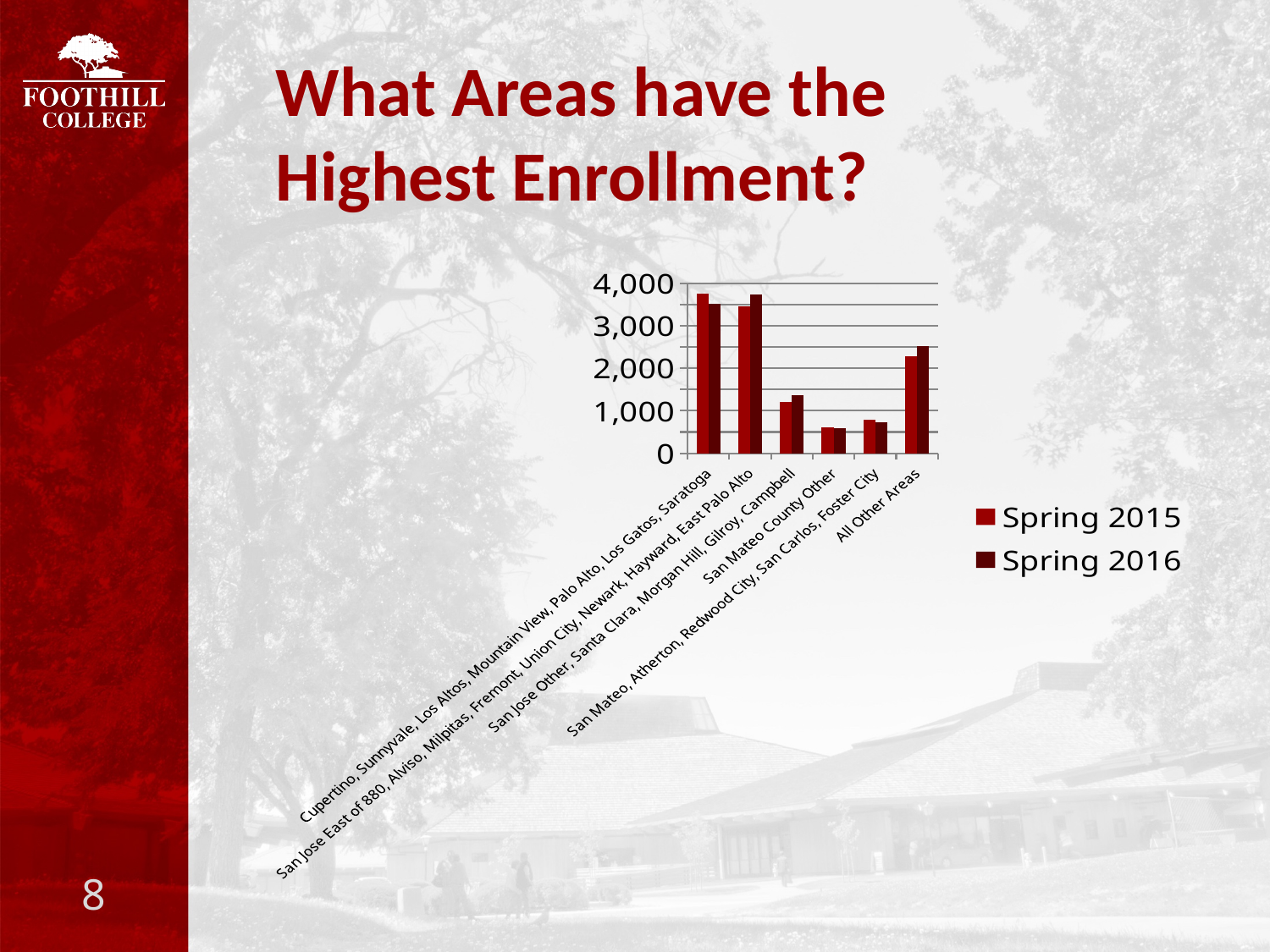
How many series does the chart's legend list? 2 Which area category has the lowest Spring 2016 enrollment? San Mateo County Other Which area category has the highest Spring 2015 enrollment? Cupertino, Sunnyvale, Los Altos, Mountain View, Palo Alto, Los Gatos, Saratoga Which area category has the highest Spring 2016 enrollment? San Jose East of 880, Alviso, Milpitas, Fremont, Union City, Newark, Hayward, East Palo Alto For All Other Areas, which is larger: the Spring 2015 value or the Spring 2016 value? Spring 2016 For Cupertino, Sunnyvale, Los Altos, Mountain View, Palo Alto, Los Gatos, Saratoga, which is larger: the Spring 2015 value or the Spring 2016 value? Spring 2015 Is the Spring 2015 value for San Mateo County Other greater or less than 1,000? less How many area categories are shown on the x axis of the chart? 6 What are the two series named in the chart's legend? Spring 2015 and Spring 2016 What kind of chart is shown on the slide? Bar chart Is the Spring 2015 value for Cupertino, Sunnyvale, Los Altos, Mountain View, Palo Alto, Los Gatos, Saratoga greater or less than 3,000? greater Is the Spring 2016 value for All Other Areas greater or less than 2,000? greater